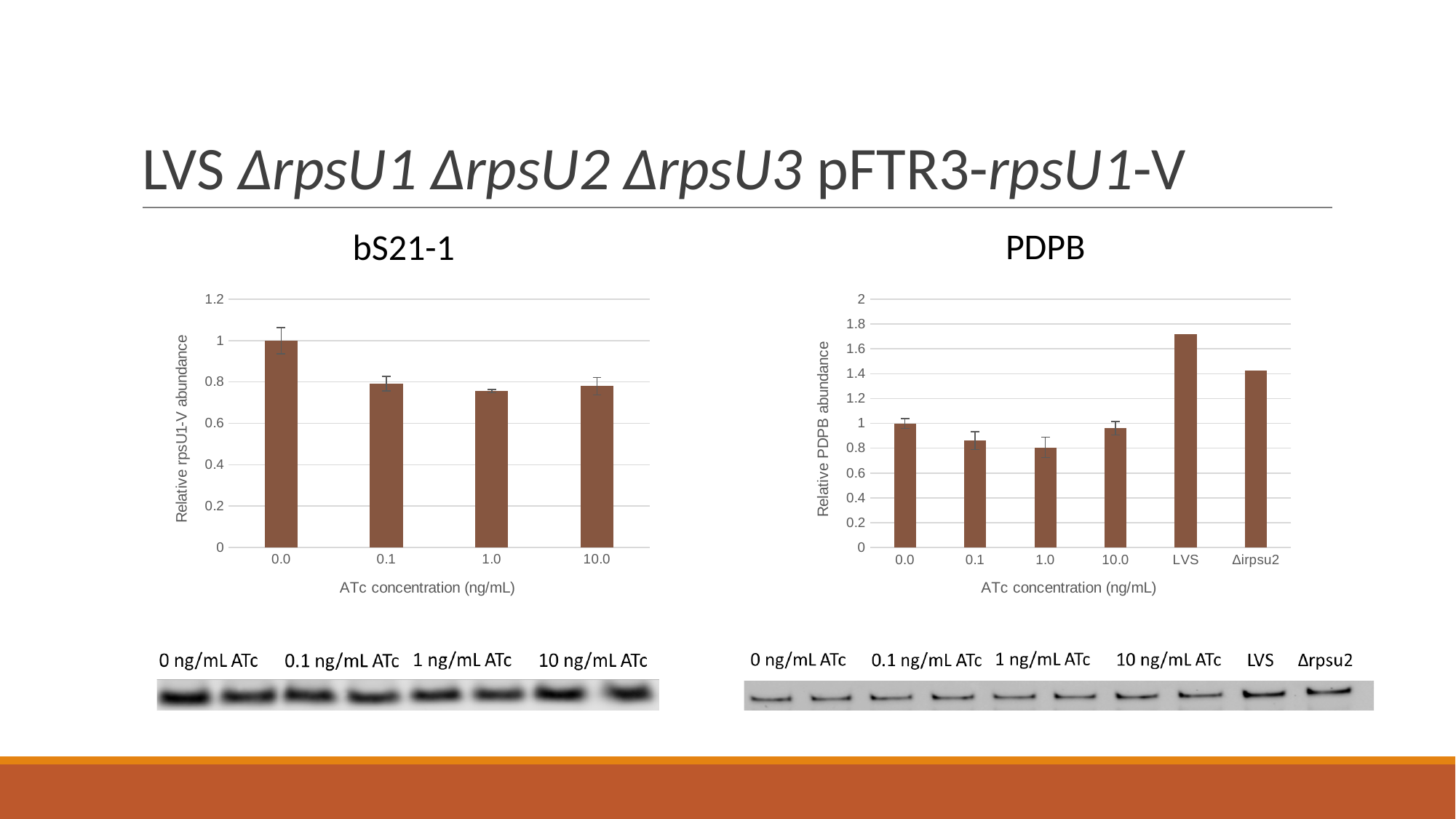
In the PDPB chart, is the value for Δirpsu2 greater or less than 1.6? less What is the y-axis title of the PDPB chart? Relative PDPB abundance How many bars are in the PDPB chart? 6 In the PDPB chart, which is larger, the value for LVS or the value for Δirpsu2? LVS In the bS21-1 chart, is the value for 10.0 ng/mL ATc greater or less than 1? less What kind of chart is the bS21-1 chart? bar chart How many bars are in the bS21-1 chart? 4 In the bS21-1 chart, is the value for 1.0 ng/mL ATc greater or less than 0.8? less In the PDPB chart, which category has the highest relative PDPB abundance? LVS In the bS21-1 chart, which ATc concentration has the highest relative rpsU1-V abundance? 0.0